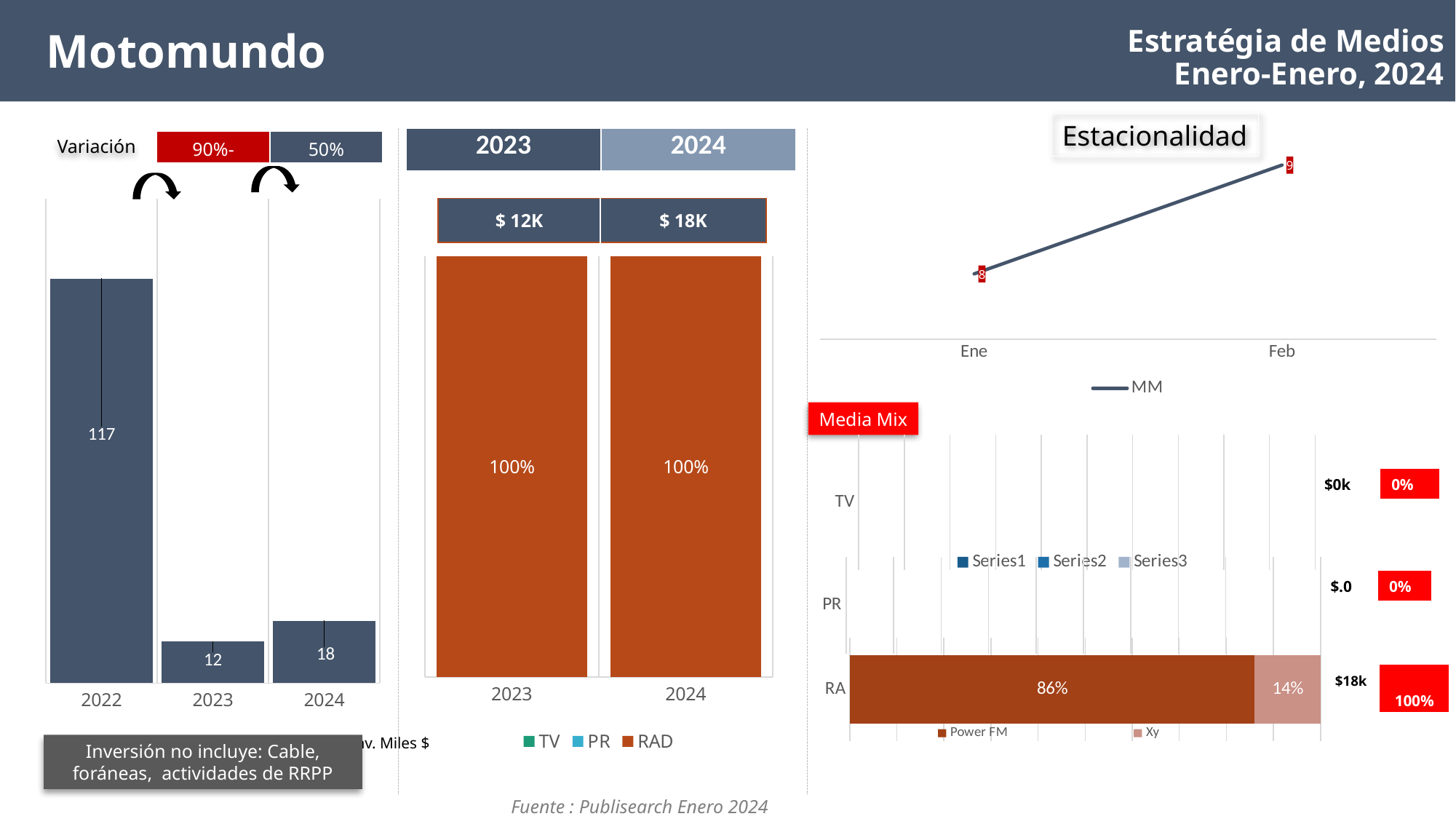
In the leftmost bar chart (years 2022-2024), what is the difference between the 2022 and 2023 values? 105 In the leftmost bar chart (years 2022-2024), which year has the highest value? 2022 In the Media Mix chart, what share of the RA bar is Power FM? 86% In the leftmost bar chart (years 2022-2024), what is the value for 2022? 117 In the leftmost bar chart (years 2022-2024), what is the value for 2024? 18 In the middle stacked bar chart (2023 vs 2024), how many series does the legend list? 3 In the Estacionalidad chart, what is the MM value for Feb? 9 In the leftmost bar chart (years 2022-2024), how many years are shown on the x axis? 3 In the leftmost bar chart (years 2022-2024), which year has the lowest value? 2023 In the Estacionalidad chart, does the MM line rise or fall from Ene to Feb? rise In the middle stacked bar chart (2023 vs 2024), what percentage does RAD account for in 2024? 100% In the middle stacked bar chart (2023 vs 2024), what total is shown above the 2023 bar? $ 12K